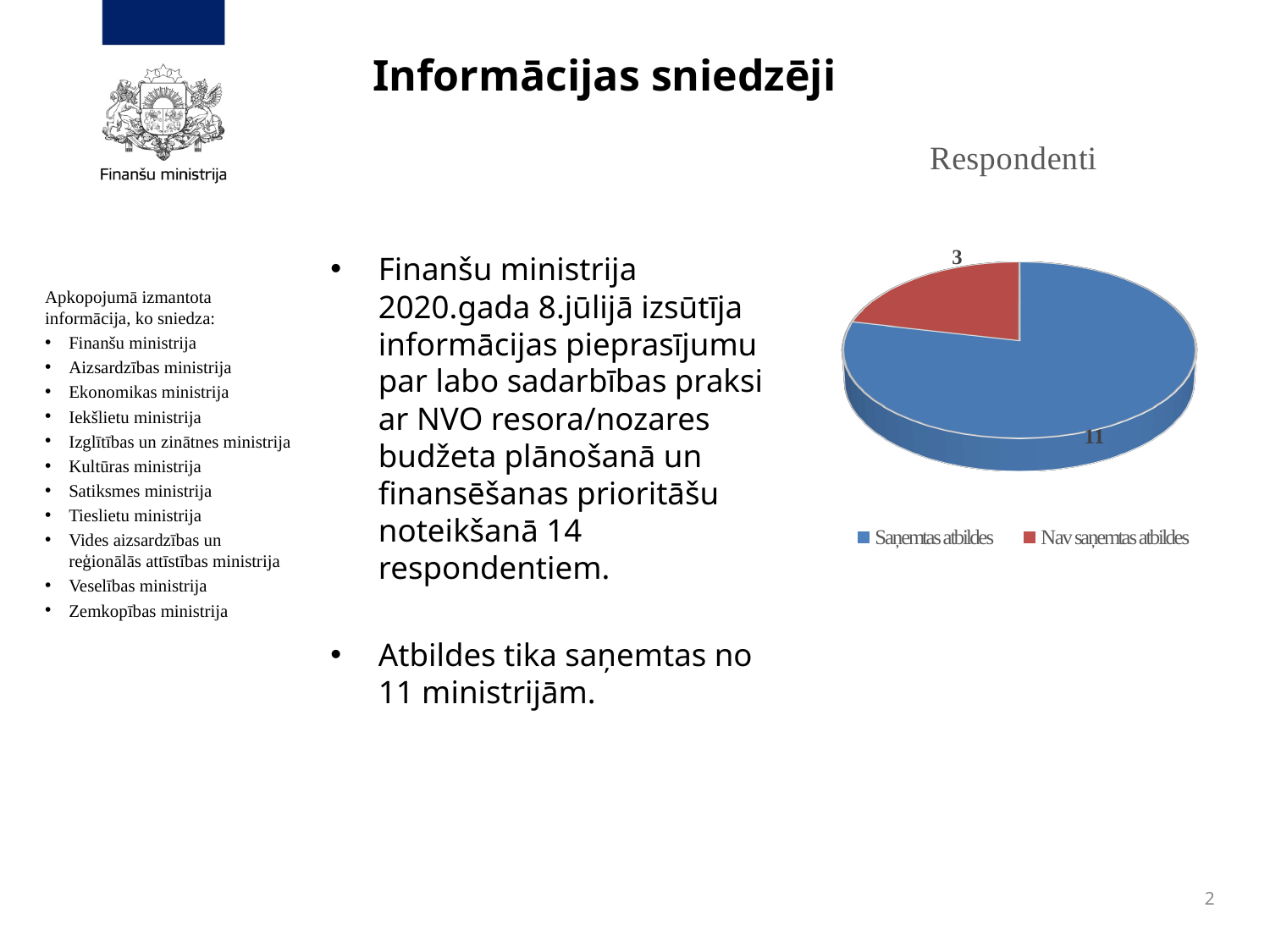
How many entries does the legend list? 2 What is the difference between the values for Saņemtas atbildes and Nav saņemtas atbildes? 8 Which colour represents Nav saņemtas atbildes in the pie chart? red Which category has the smallest slice in the pie chart? Nav saņemtas atbildes What is the value for Nav saņemtas atbildes in the pie chart? 3 What is the title of the chart? Respondenti Which category has the largest slice in the pie chart? Saņemtas atbildes Which is larger, Saņemtas atbildes or Nav saņemtas atbildes? Saņemtas atbildes What is the total of all slices in the pie chart? 14 What type of chart is shown on the slide? pie chart How many slices does the pie chart have? 2 What is the value for Saņemtas atbildes in the pie chart? 11